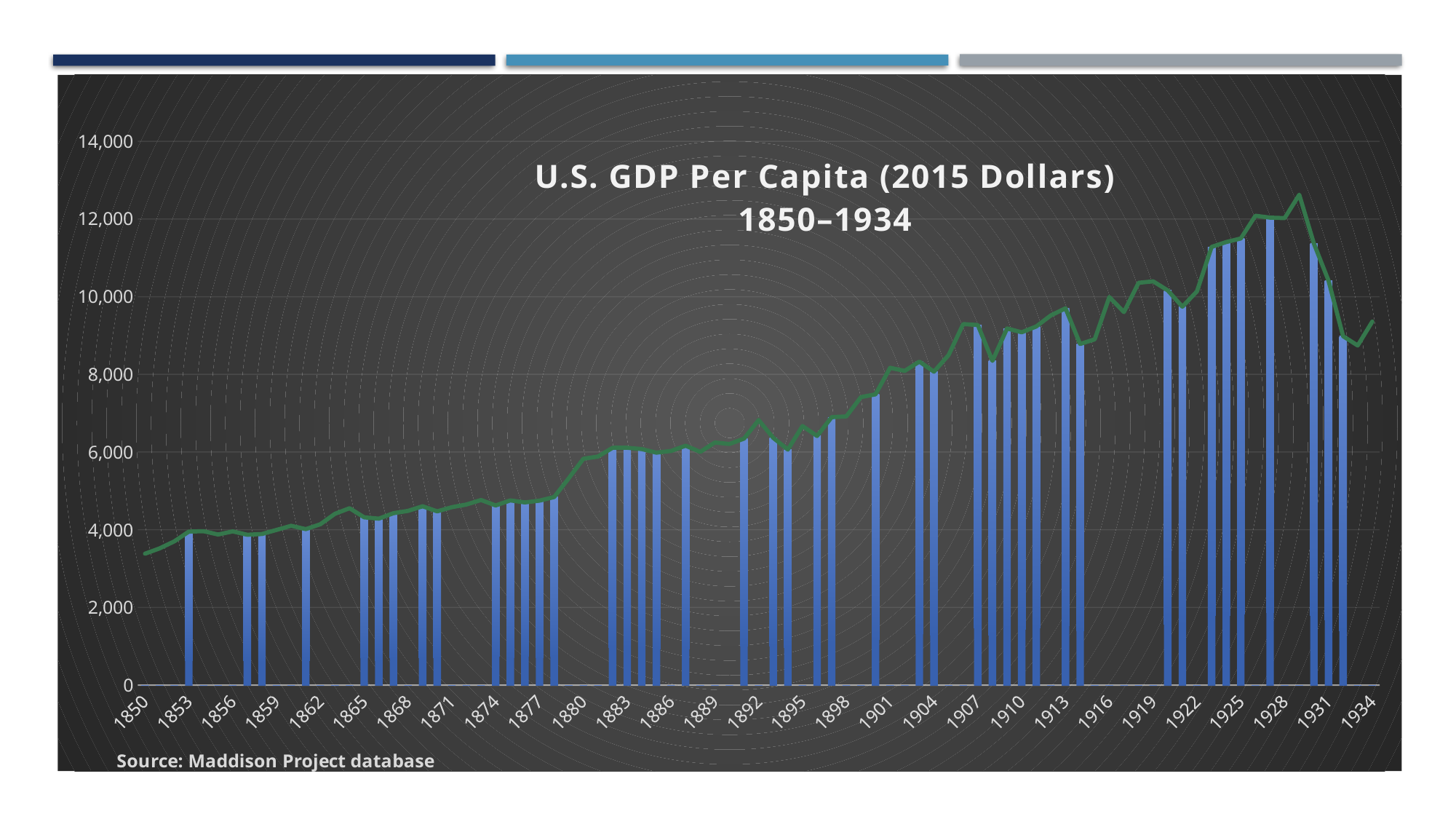
Overall, do the values rise or fall from 1850 to 1934? Rise Is the value for 1913 greater or less than 10,000? less Is the value for 1931 greater or less than 10,000? greater What source is cited for the chart data? Maddison Project database What kind of chart is shown on the slide? Bar chart with a line overlay Is the value for 1850 greater or less than 4,000? less Which is larger, the value for 1928 or the value for 1931? 1928 Which year has the highest bar in the chart? 1928 What is the title of the chart? U.S. GDP Per Capita (2015 Dollars) 1850–1934 Which is larger, the value for 1850 or the value for 1934? 1934